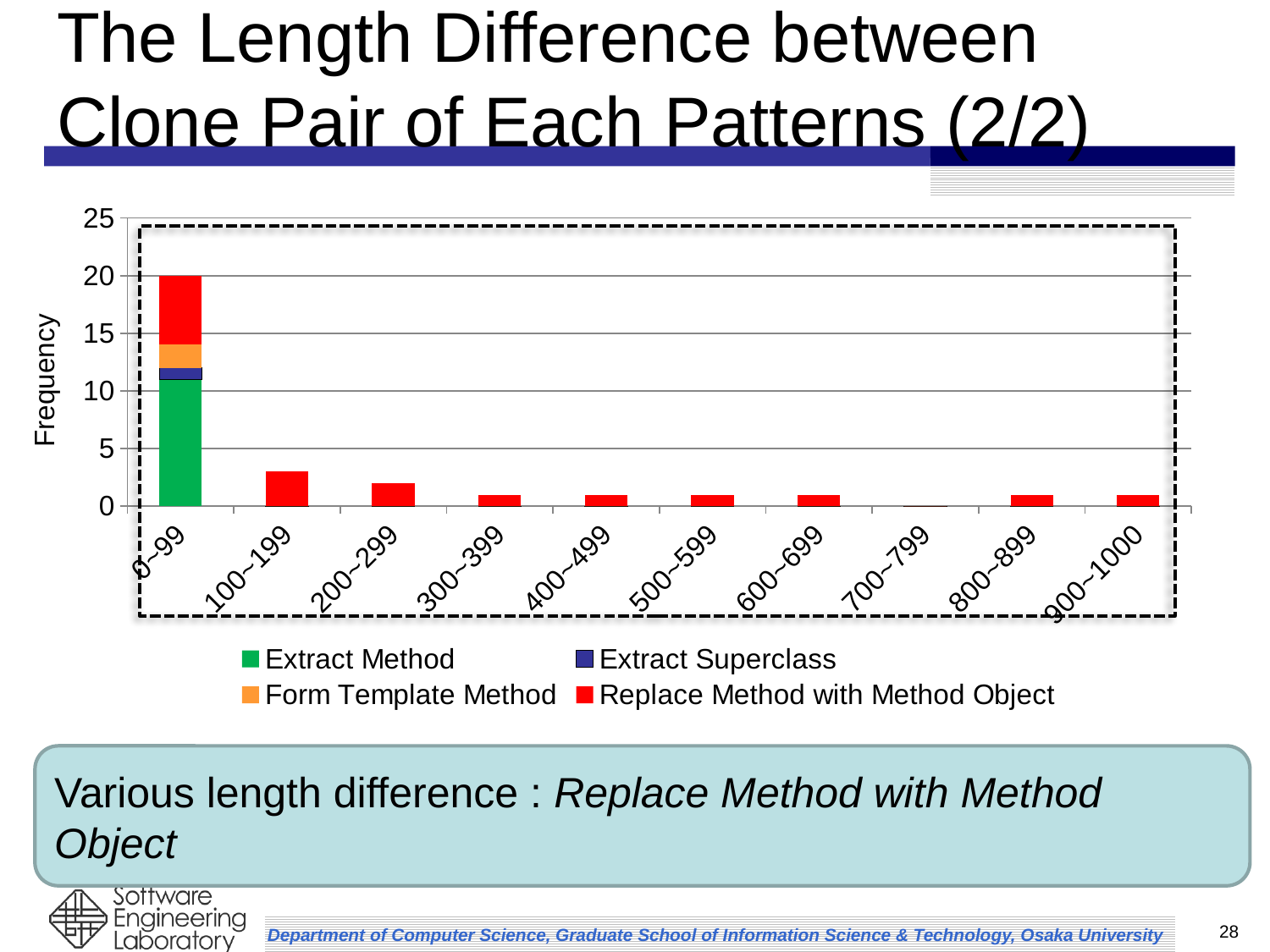
How many series does the legend list? 4 Which category has the highest total frequency? 0~99 Which series is shown in red in the legend? Replace Method with Method Object Is the Extract Method value for 0~99 greater or less than 10? greater What is the total frequency of the stacked bar for 0~99? 20 Is the total frequency for 100~199 greater or less than 5? less What kind of chart is shown on the slide? bar chart What is the label of the y axis? Frequency Which has the larger total frequency, 100~199 or 200~299? 100~199 Which category has the lowest total frequency? 700~799 Is the total frequency for 0~99 greater or less than 15? greater How many length-difference categories are shown on the x axis? 10